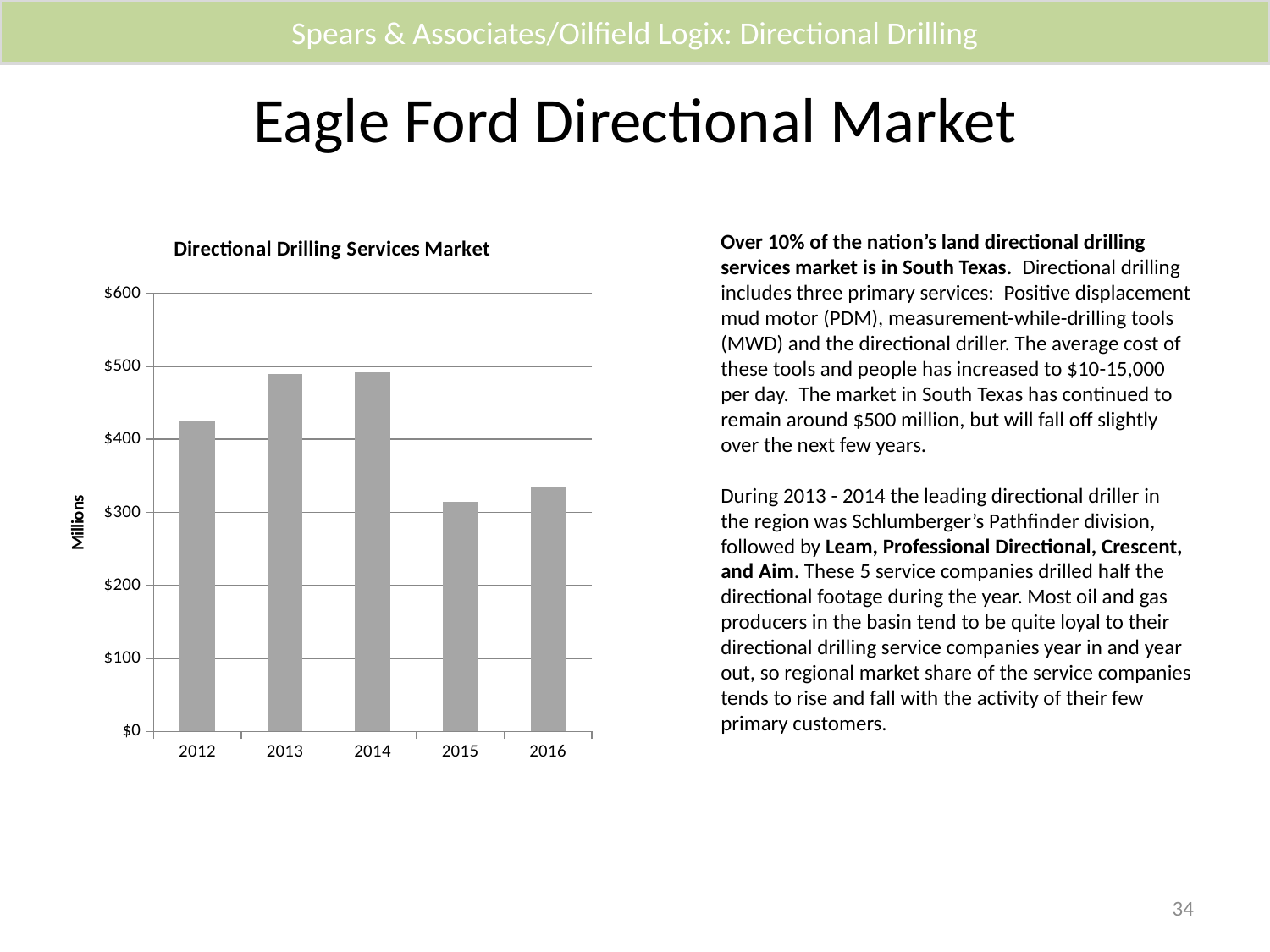
Is the value for 2015 greater or less than $400? less Does the value rise or fall from 2014 to 2015? Fall What type of chart is shown on the slide? Bar chart Is the value for 2016 greater or less than $300? greater What is the title of the chart on the slide? Directional Drilling Services Market Which is larger, the value for 2013 or the value for 2016? 2013 What is the label on the vertical axis of the chart? Millions Is the value for 2014 greater or less than $400? greater Which is larger, the value for 2012 or the value for 2015? 2012 Which year has the lowest value in the chart? 2015 How many years are shown on the x axis of the chart? 5